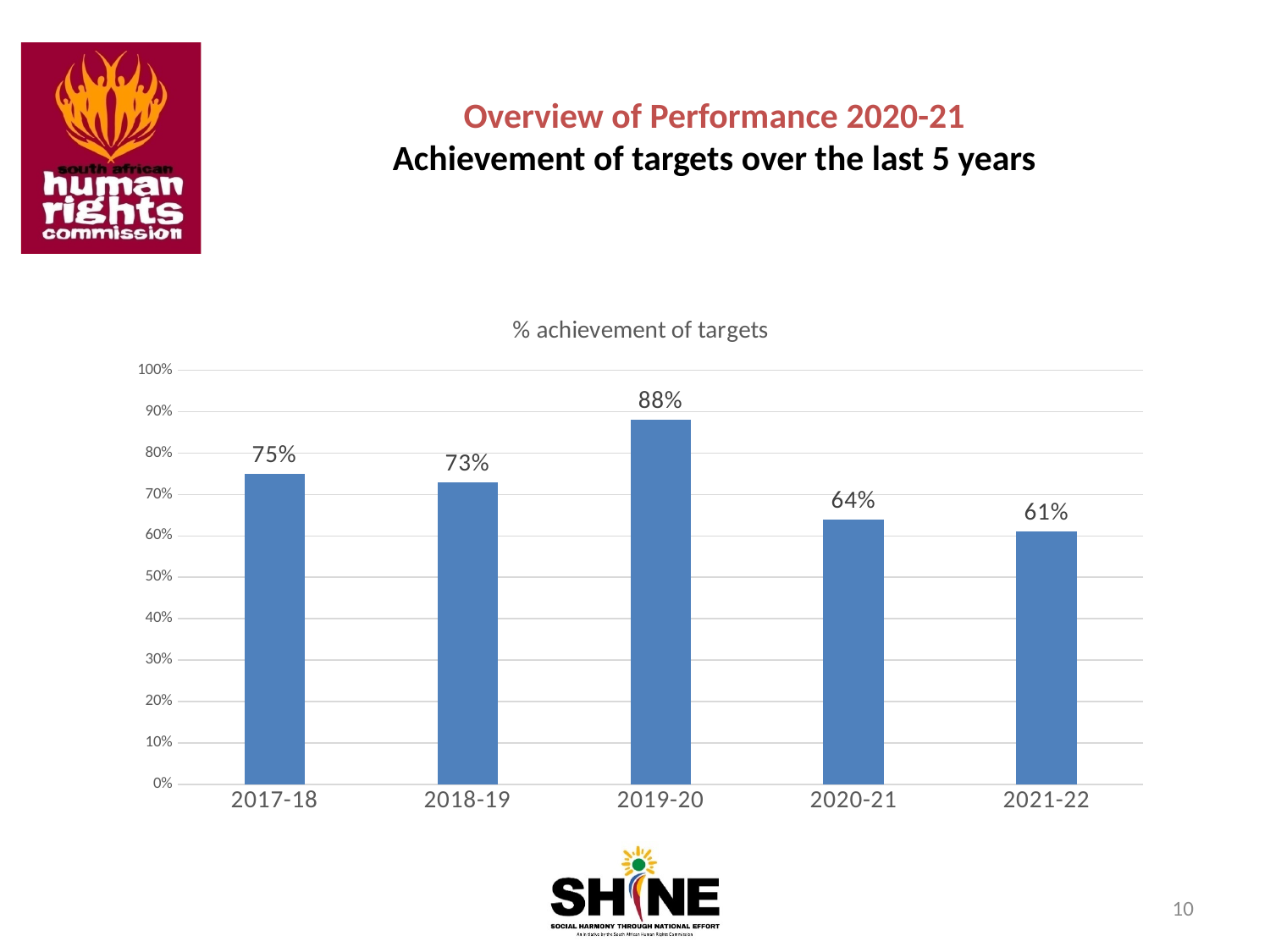
Is the value for 2020-21 greater or less than 70%? less Which year has the highest % achievement of targets? 2019-20 What is the difference in % achievement of targets between 2019-20 and 2020-21? 24% What is the difference in % achievement of targets between 2017-18 and 2018-19? 2% What is the % achievement of targets for 2017-18? 75% How many years are shown on the chart? 5 Which year has a higher % achievement of targets, 2018-19 or 2020-21? 2018-19 Which year has the lowest % achievement of targets? 2021-22 What kind of chart is shown on the slide? Bar chart What is the % achievement of targets for 2019-20? 88% What is the title of the chart? % achievement of targets What is the % achievement of targets for 2021-22? 61%